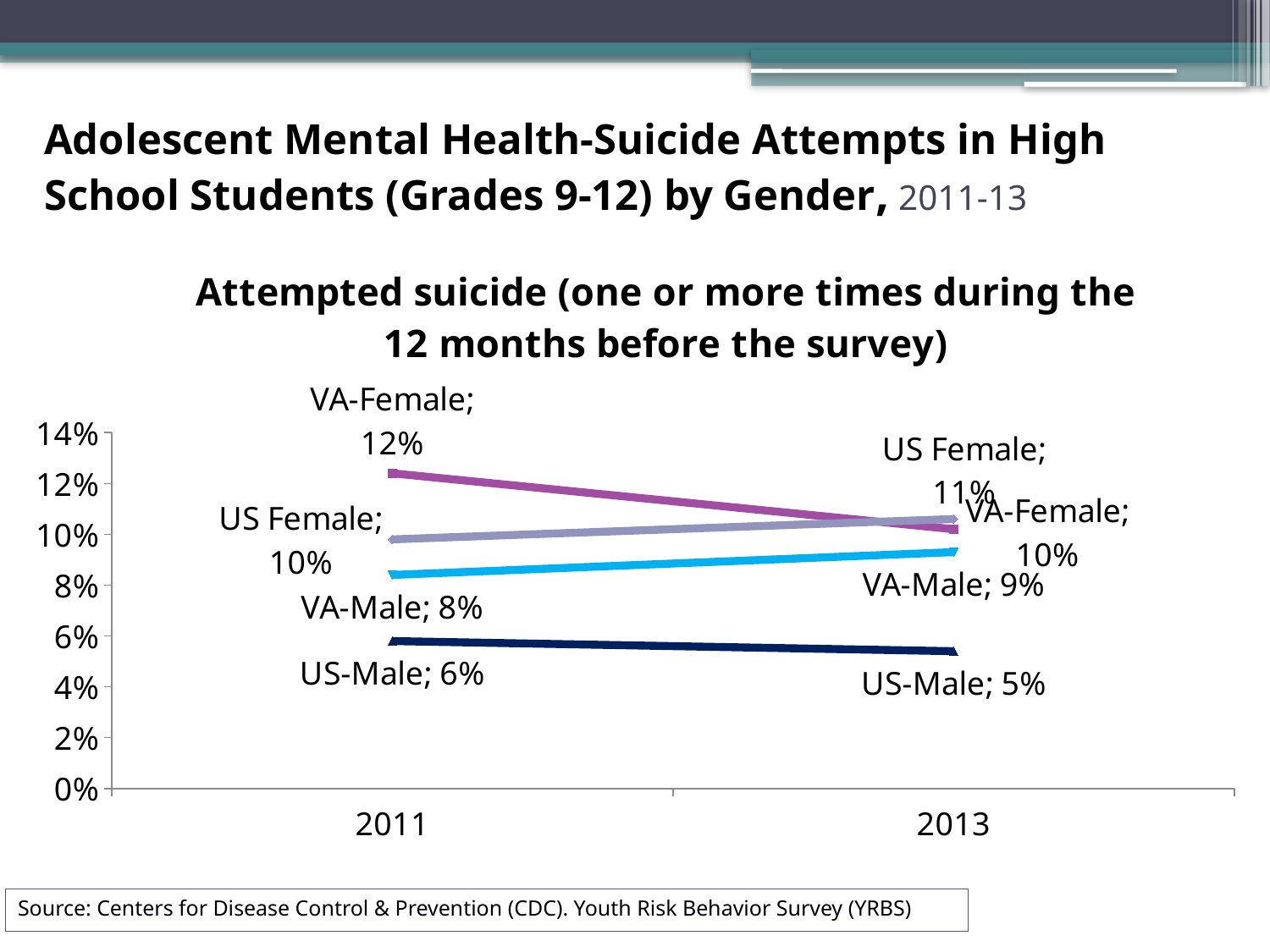
What was the VA-Male value in 2011? 8% Which group had the highest value in 2011? VA-Female What is the difference between the VA-Female value in 2011 and in 2013? 2% What type of chart is shown on the slide? Line chart Which group had the lowest value in 2013? US-Male What was the US Female value in 2013? 11% Did the VA-Male value rise or fall from 2011 to 2013? Rise What was the VA-Female value in 2011? 12% Which was larger in 2013, the US Female value or the VA-Female value? US Female How many years are shown on the x axis? 2 What was the VA-Female value in 2013? 10% What was the US-Male value in 2013? 5%